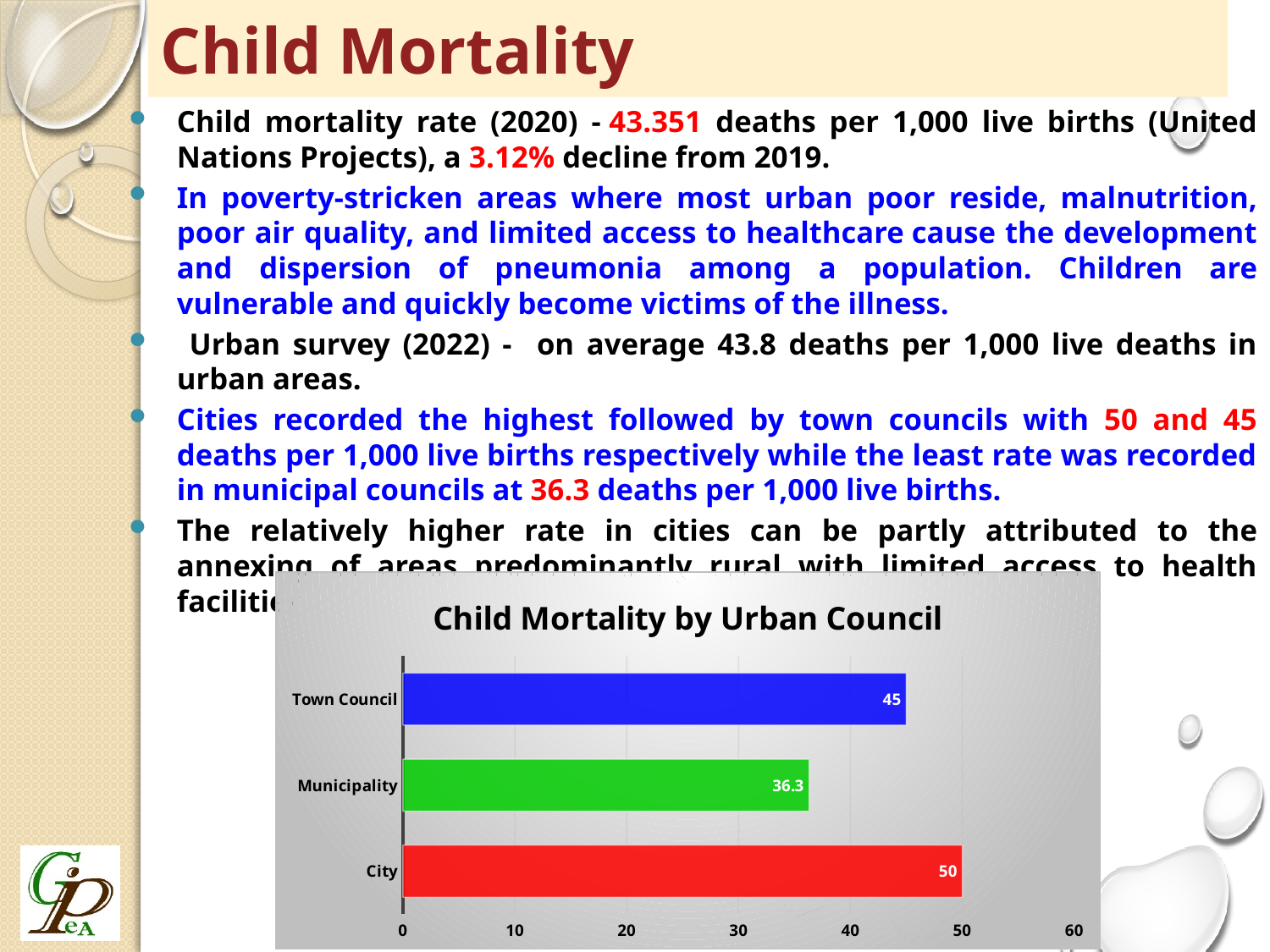
Which is larger in the chart, the value for Town Council or the value for Municipality? Town Council What is the title of the chart on the slide? Child Mortality by Urban Council What kind of chart is shown on the slide? bar chart What is the difference between the City and Town Council values in the chart? 5 What is the child mortality value for Municipality in the chart? 36.3 What is the child mortality value for Town Council in the chart? 45 Which urban council category has the highest child mortality in the chart? City What is the difference between the Town Council and Municipality values in the chart? 8.7 How many categories are shown in the chart? 3 What is the child mortality value for City in the chart? 50 Which urban council category has the lowest child mortality in the chart? Municipality Is the value for Municipality greater or less than 40? less